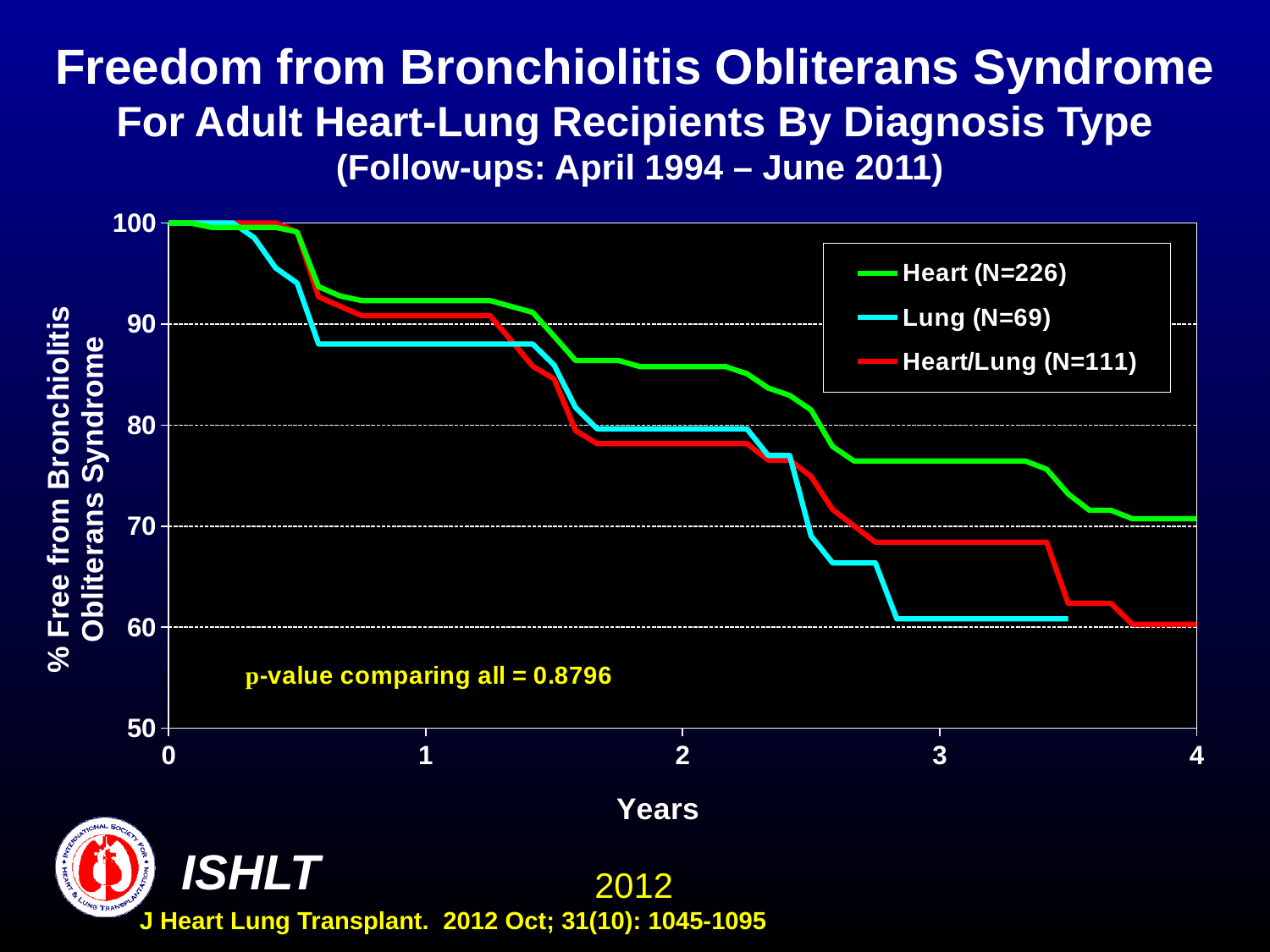
What p-value comparing all groups is printed on the chart? 0.8796 What is the N value shown in the legend for the Heart/Lung series? 111 At 3 years, which series has the higher value, Heart or Lung? Heart What is the N value shown in the legend for the Lung series? 69 Is the value for the Heart series at 2 years greater or less than 80? greater Do the values for the Heart series rise or fall as years increase along the x axis? Fall What kind of chart is shown on the slide? Line chart Is the value for the Lung series at 1 year greater or less than 90? less What is the N value shown in the legend for the Heart series? 226 Is the value for the Lung series at 3 years greater or less than 70? less How many series does the legend list? 3